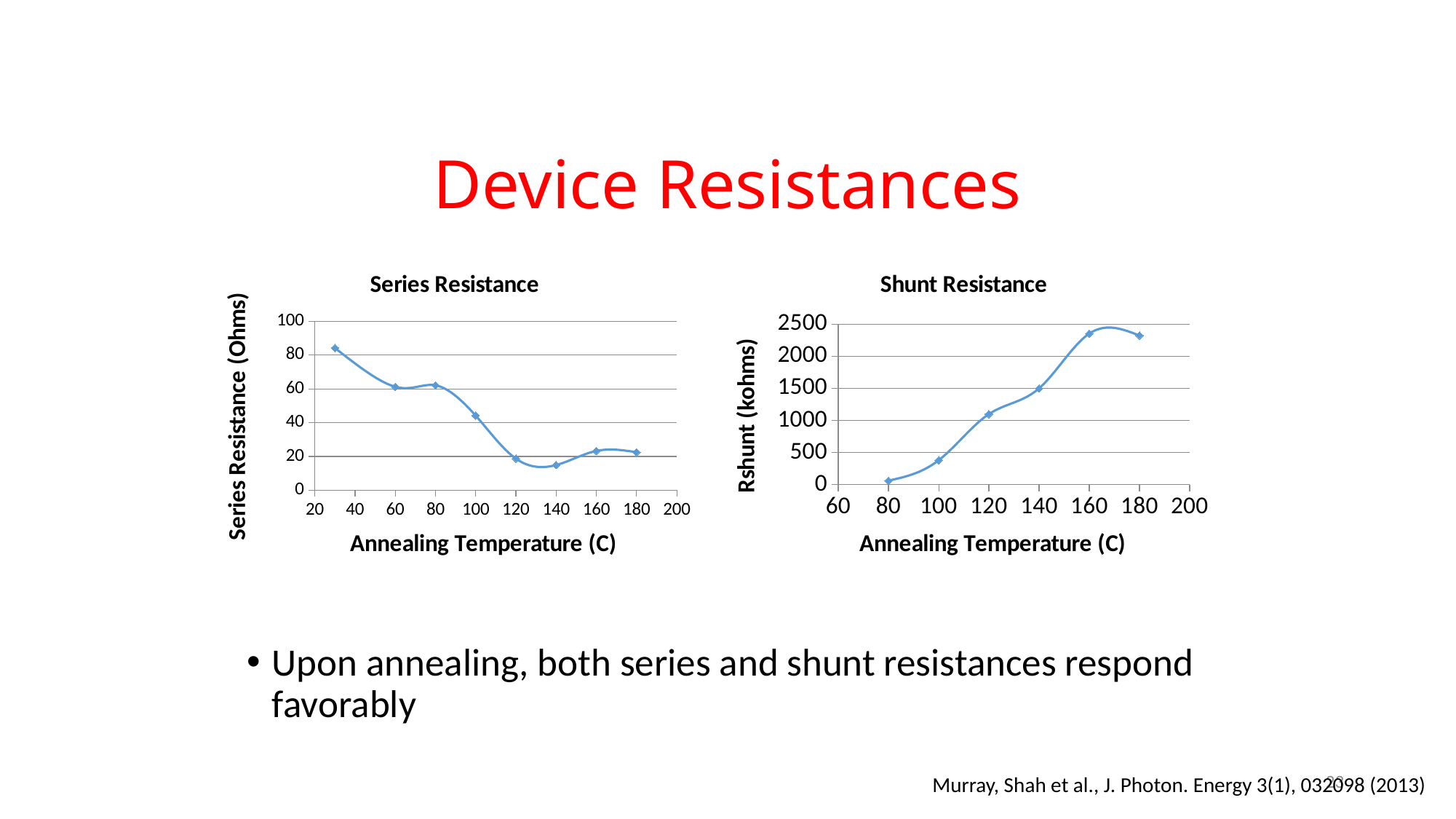
In the Series Resistance chart, do the values generally rise or fall as annealing temperature increases? fall In the Series Resistance chart, which is larger: the value at 60 C or the value at 120 C? 60 C In the Shunt Resistance chart, is the value at 100 C greater or less than 500? less In the Series Resistance chart, is the value at 120 C greater or less than 40? less How many data points are plotted in the Shunt Resistance chart? 6 How many data points are plotted in the Series Resistance chart? 8 In the Series Resistance chart, at which annealing temperature is the series resistance highest? 30 In the Shunt Resistance chart, do the values generally rise or fall as annealing temperature increases? rise In the Shunt Resistance chart, is the value at 160 C greater or less than 2000? greater What is the y-axis label of the Shunt Resistance chart? Rshunt (kohms) In the Shunt Resistance chart, at which annealing temperature is the shunt resistance lowest? 80 What kind of chart is the Series Resistance chart? line chart